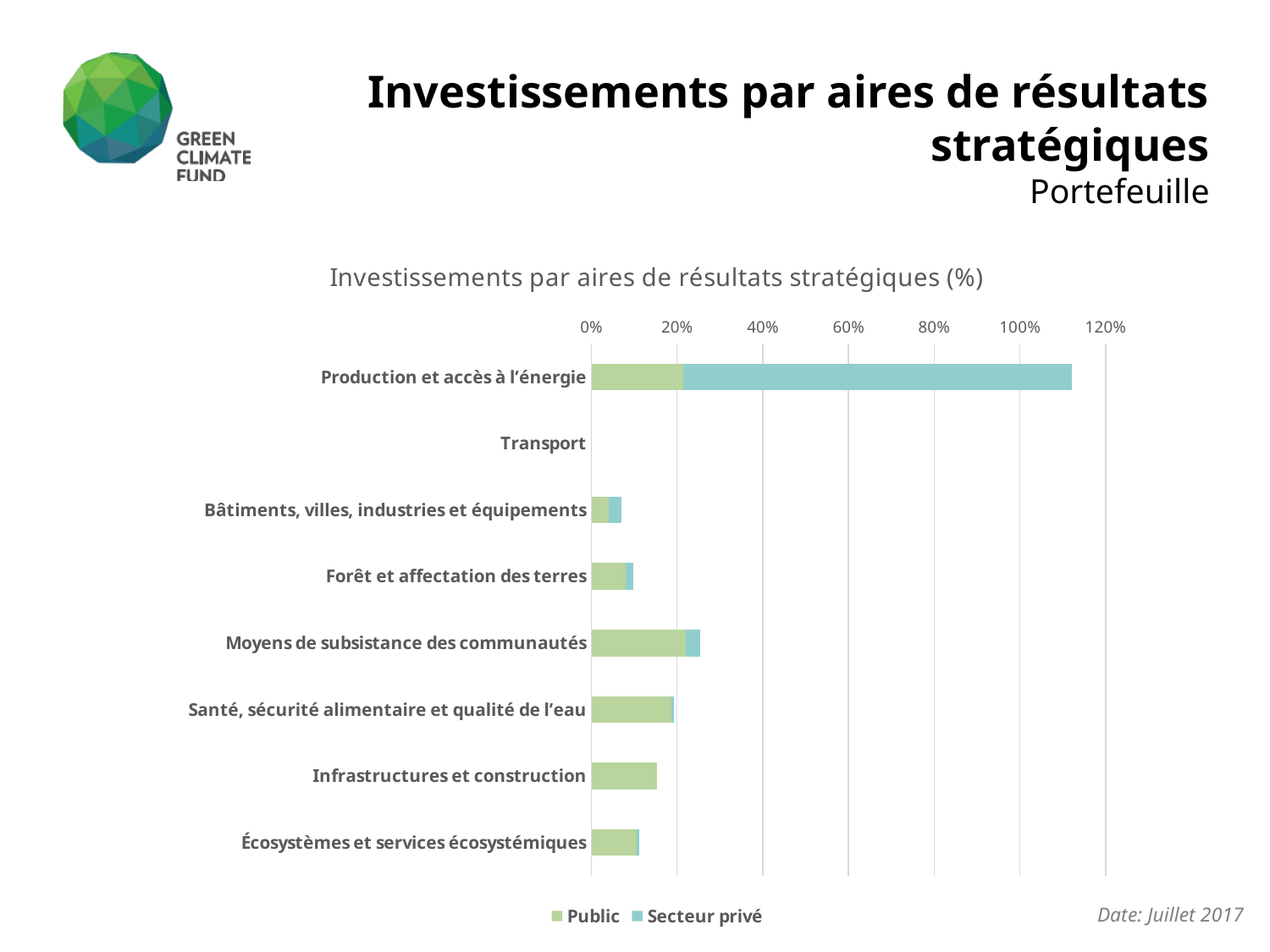
Which has the longer bar: Moyens de subsistance des communautés or Infrastructures et construction? Moyens de subsistance des communautés Which category has the longest bar overall? Production et accès à l'énergie Is the total value for Infrastructures et construction greater or less than 20%? less What is the title of the chart? Investissements par aires de résultats stratégiques (%) Is the total value for Moyens de subsistance des communautés greater or less than 20%? greater What are the two series named in the legend? Public and Secteur privé Which category shows no visible bar at all? Transport What kind of chart is shown on the slide? bar chart Is the total value for Production et accès à l'énergie greater or less than 100%? greater How many categories (result areas) are listed on the chart? 8 How many series does the legend list? 2